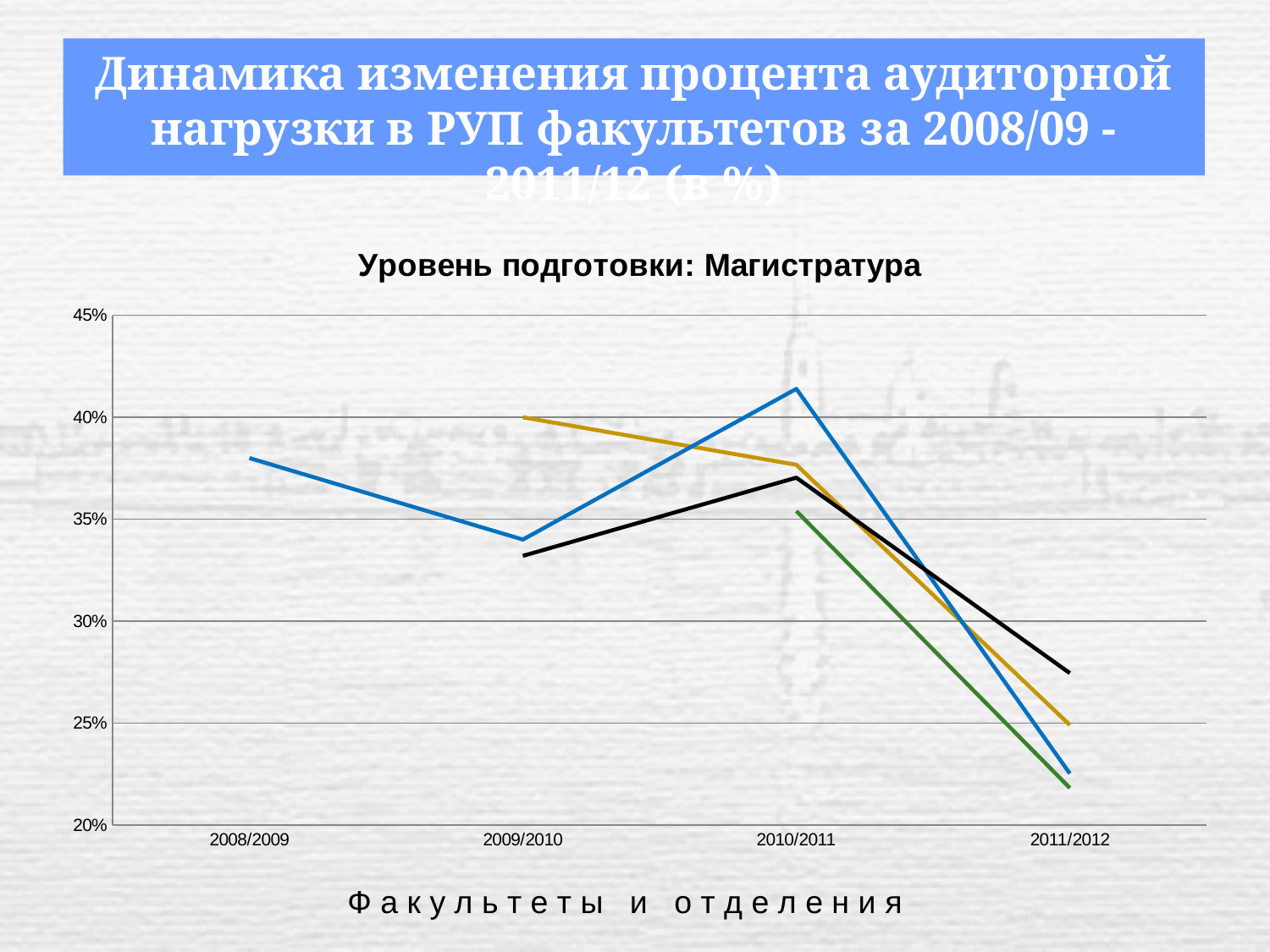
What is the title of the chart? Уровень подготовки: Магистратура Does the blue line rise or fall from 2010/2011 to 2011/2012? fall How many lines are plotted on the chart? 4 Is the value of the blue line for 2010/2011 greater or less than 40%? greater What kind of chart is shown on the slide? line chart How many academic years are shown on the x axis of the chart? 4 Is the value of the blue line for 2008/2009 greater or less than 35%? greater What is the x-axis title of the chart? Факультеты и отделения At 2010/2011, which is larger: the blue line or the gold line? the blue line Is the value of the blue line for 2011/2012 greater or less than 25%? less Which line has the highest value at 2010/2011? the blue line